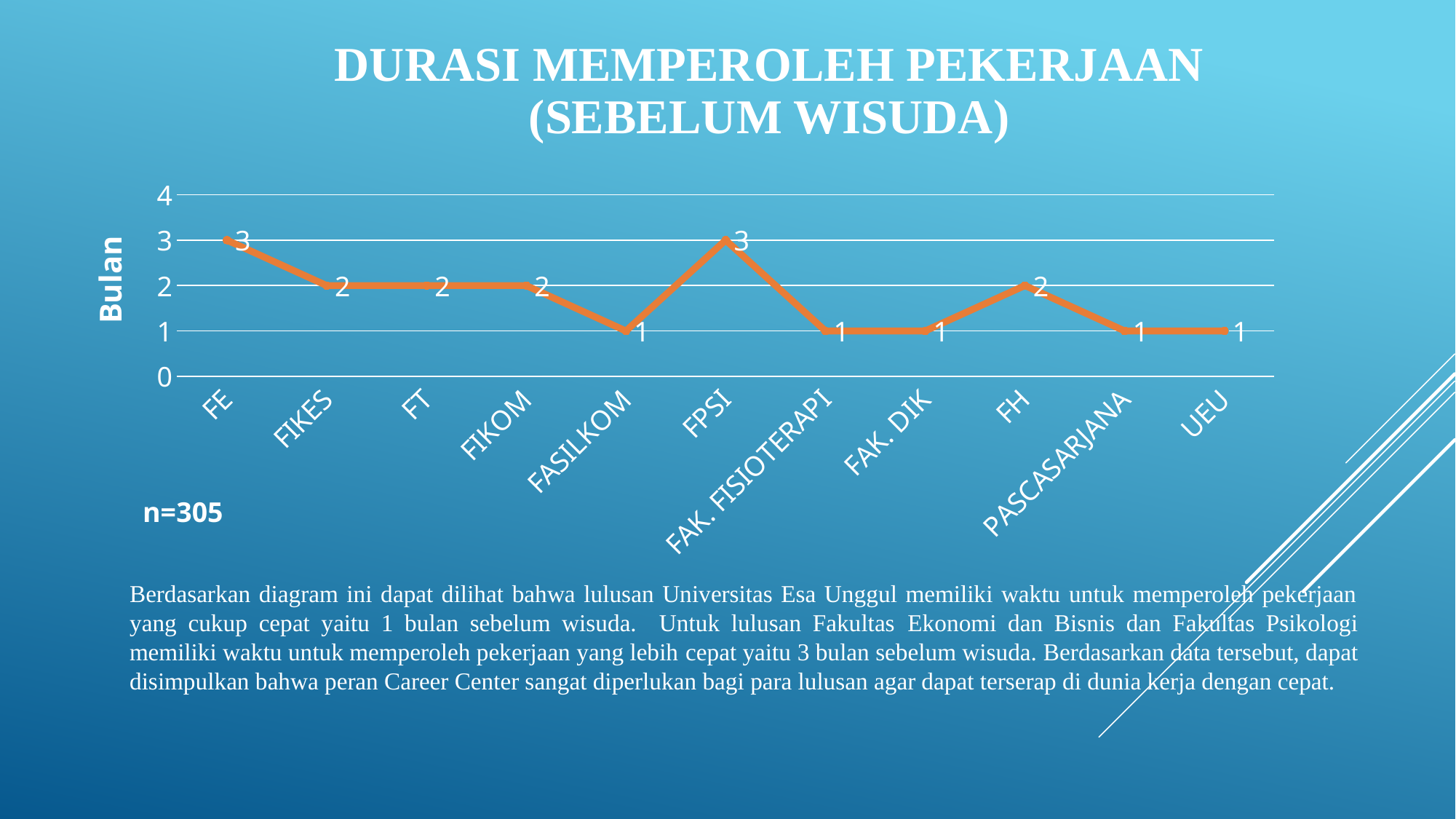
What is the label of the vertical axis? Bulan What type of chart is shown on the slide? line chart What is the value for UEU? 1 What is the value for FH? 2 What is the value for FPSI? 3 What is the difference between the values for FE and FIKES? 1 What is the difference between the values for FPSI and FAK. FISIOTERAPI? 2 Which two categories share the highest value on the chart? FE and FPSI What is the value for FE? 3 Which has the larger value, FH or PASCASARJANA? FH How many categories are plotted along the x axis? 11 What is the value for FASILKOM? 1